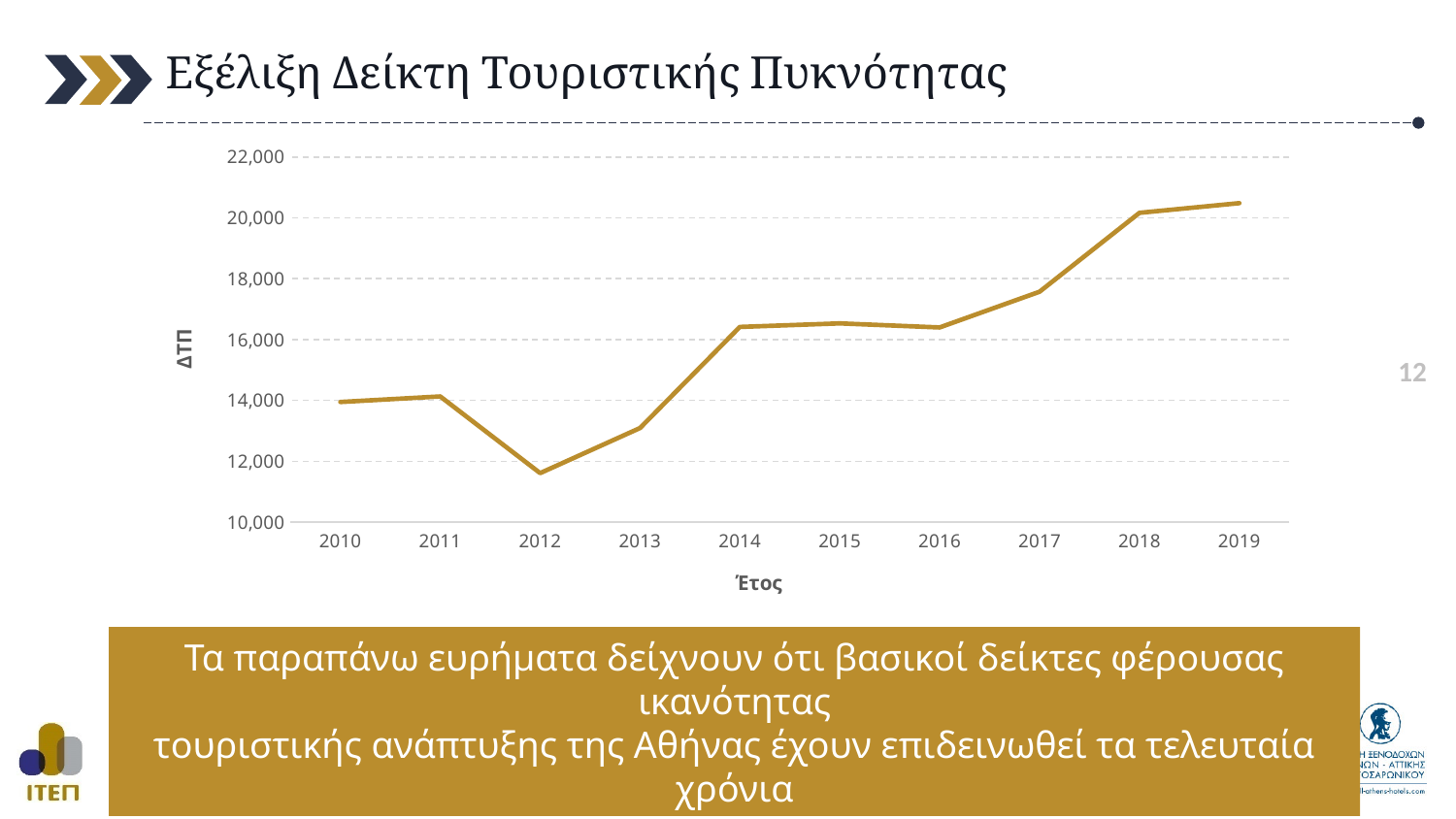
Does the index rise or fall between 2016 and 2019? rise Is the value for 2014 greater or less than 16,000? greater How many years are plotted on the x axis of the chart? 10 What is the label of the x axis of the chart? Έτος Is the value for 2012 greater or less than 12,000? less What is the title of the chart on the slide? Εξέλιξη Δείκτη Τουριστικής Πυκνότητας What kind of chart is shown on the slide? line chart Which year has the larger value, 2017 or 2013? 2017 In which year is the tourism density index (ΔΤΠ) highest? 2019 In which year is the tourism density index (ΔΤΠ) lowest? 2012